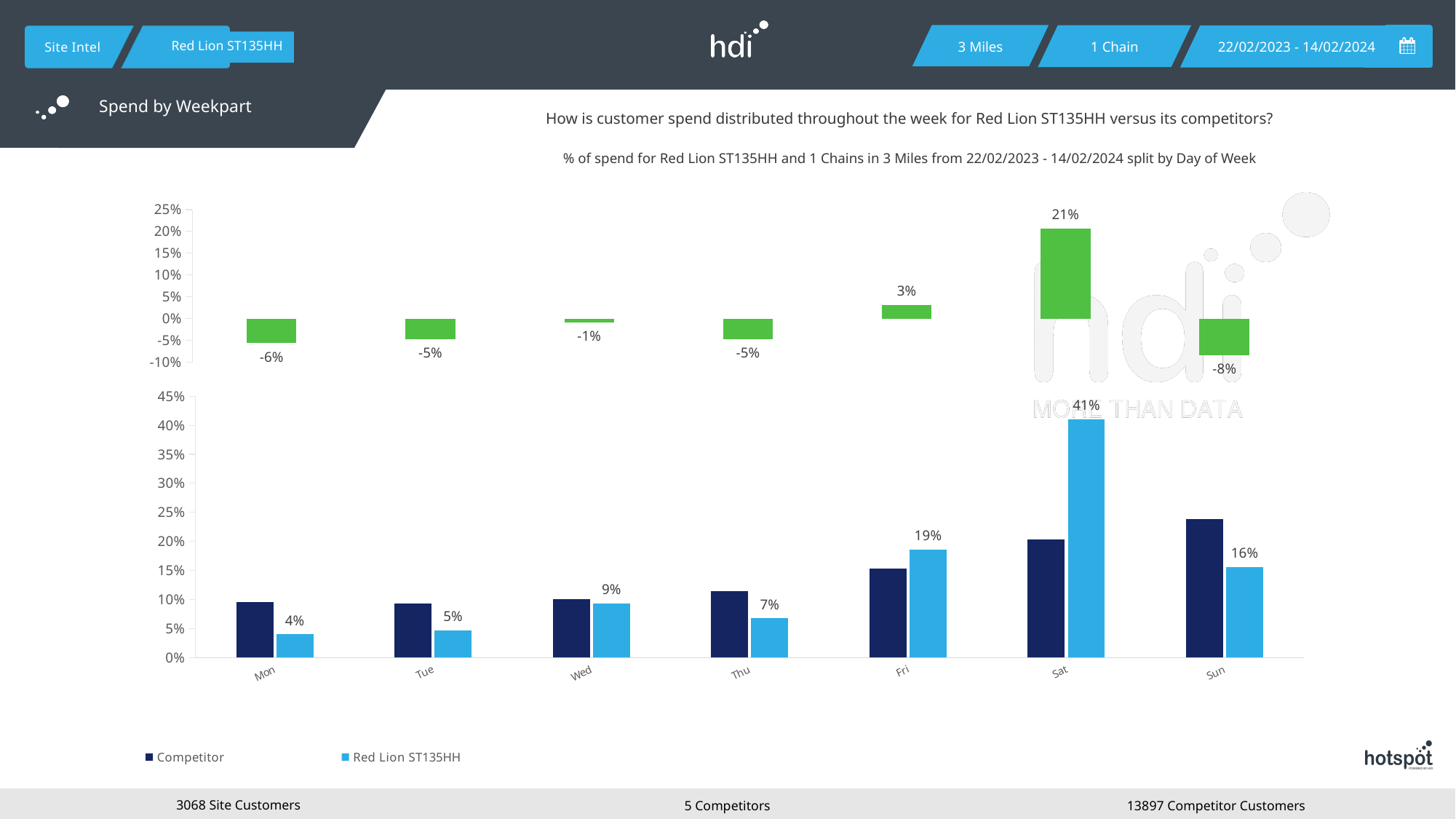
In the top chart, what is the value shown for Sun? -8% In the bottom chart, which series has the larger value on Sun, Competitor or Red Lion ST135HH? Competitor In the top chart, which day has the highest value? Sat What kind of chart is the bottom chart? Bar chart In the bottom chart, what is the value for Red Lion ST135HH on Sat? 41% In the bottom chart, what is the difference between the Red Lion ST135HH values for Sat and Fri? 22 percentage points In the bottom chart, is the Competitor value for Sun greater or less than 20%? greater In the top chart, what is the value shown for Fri? 3% How many days of the week are shown on the x axis of the bottom chart? 7 In the bottom chart, on which day is the Red Lion ST135HH value lowest? Mon In the top chart, which day has the lowest value? Sun How many series does the legend of the bottom chart list? 2